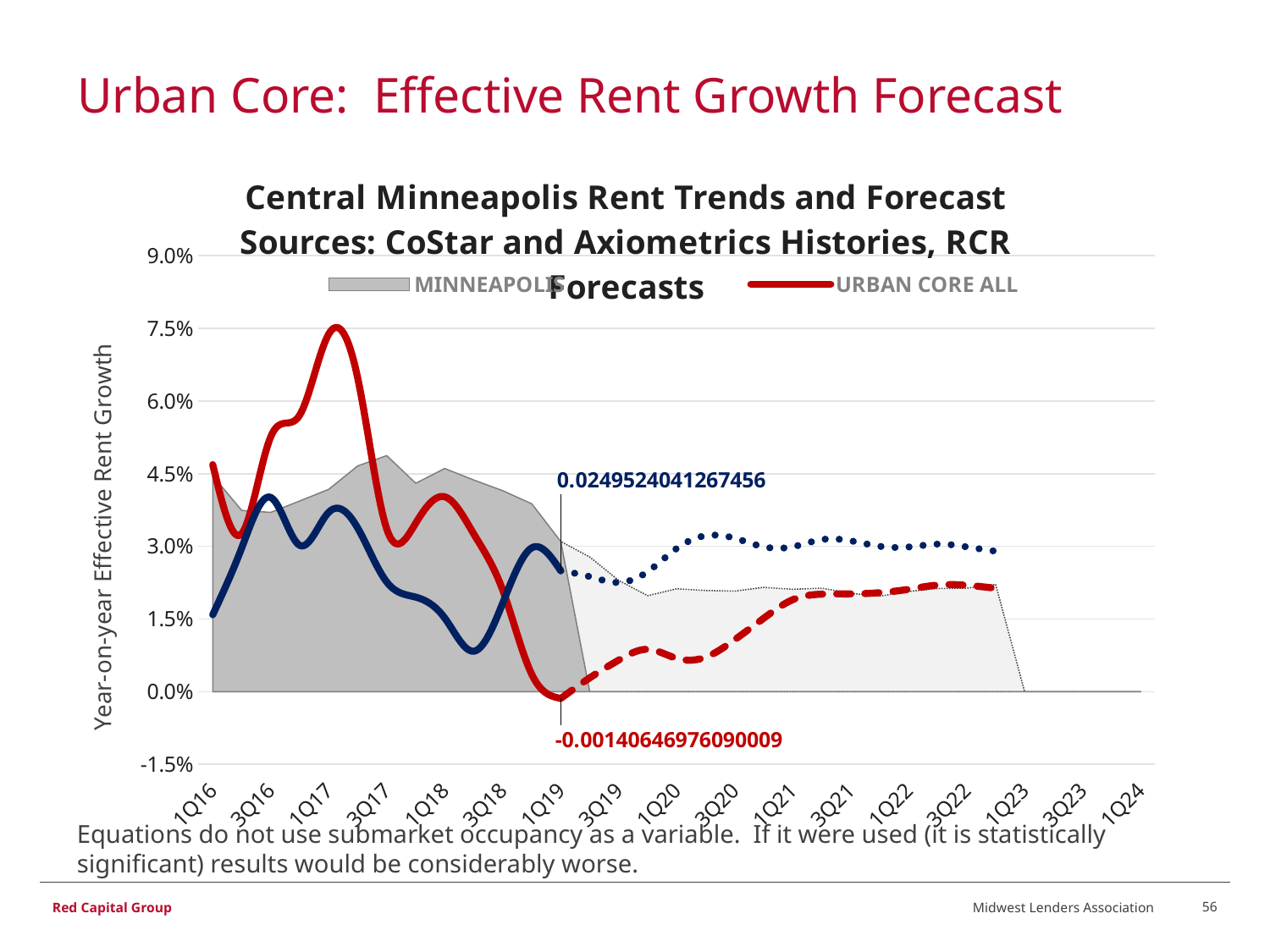
Does the URBAN CORE ALL series rise or fall between 1Q18 and 1Q19? fall Is the peak value of the URBAN CORE ALL series around 1Q17 greater or less than 6.0%? greater Is the value for URBAN CORE ALL at 3Q19 greater or less than 1.5%? less What kind of chart is shown on the slide? combination area and line chart Is the MINNEAPOLIS value at 3Q17 greater or less than 3.0%? greater What value is printed as the data label for the URBAN CORE ALL (red) series at 1Q19? -0.00140646976090009 Which series reaches the highest value on the chart? URBAN CORE ALL What value is printed as the data label for the blue line at 1Q19? 0.0249524041267456 How many series does the legend list? 2 What is the title of the vertical axis? Year-on-year Effective Rent Growth Which of the two labelled values at 1Q19 is larger, the blue line's or the red URBAN CORE ALL line's? the blue line's (0.0249524041267456)